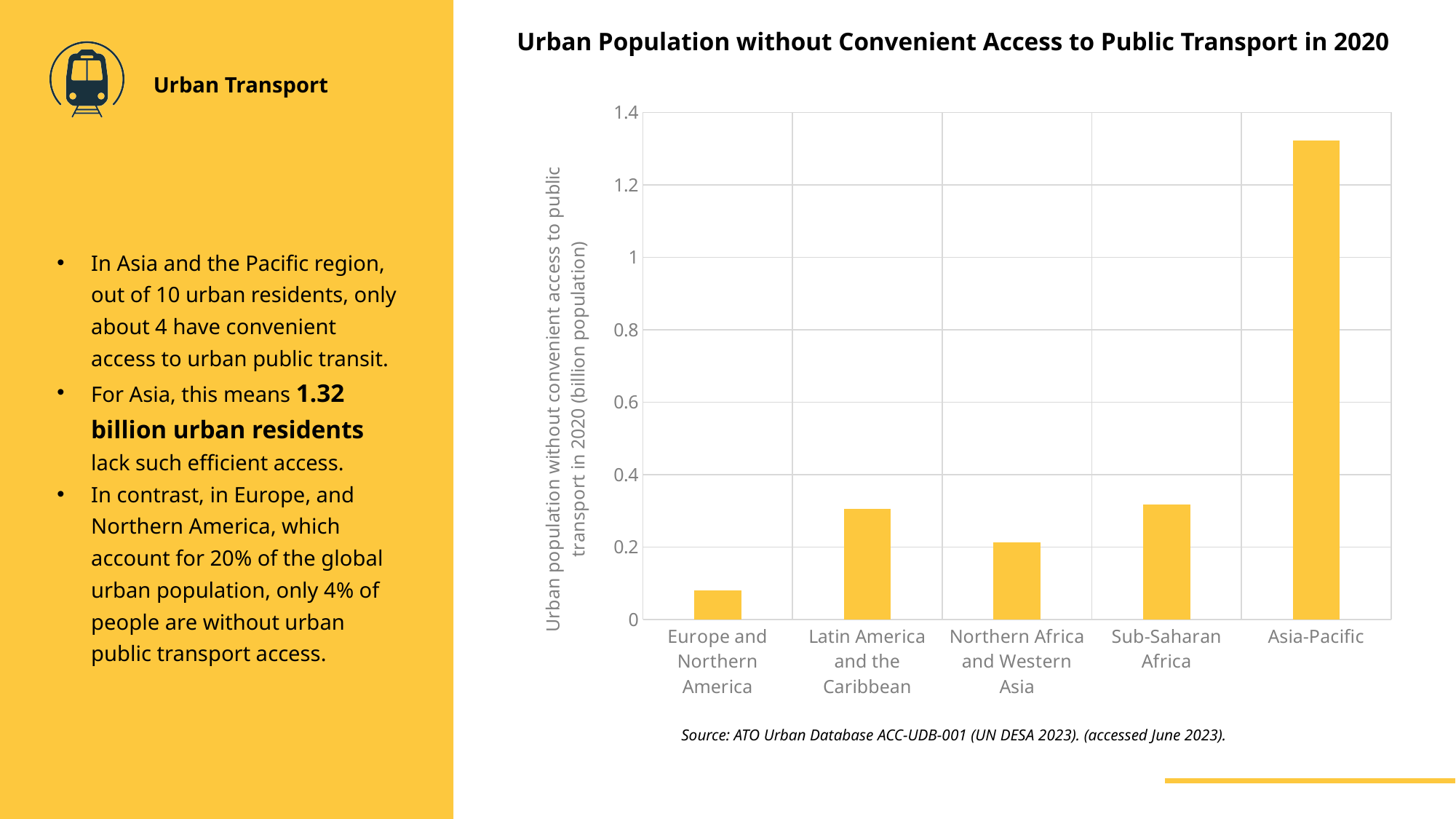
How many regions are shown on the x axis of the chart? 5 Which has a larger value: Europe and Northern America or Northern Africa and Western Asia? Northern Africa and Western Asia What kind of chart is shown on the slide? Bar chart Is the value for Europe and Northern America greater or less than 0.2? less Which region has the lowest urban population without convenient access to public transport? Europe and Northern America What is the title of the chart? Urban Population without Convenient Access to Public Transport in 2020 Is the value for Asia-Pacific greater or less than 1.2? greater Is the value for Latin America and the Caribbean greater or less than 0.2? greater Which region has the highest urban population without convenient access to public transport? Asia-Pacific Which has a larger value: Northern Africa and Western Asia or Latin America and the Caribbean? Latin America and the Caribbean